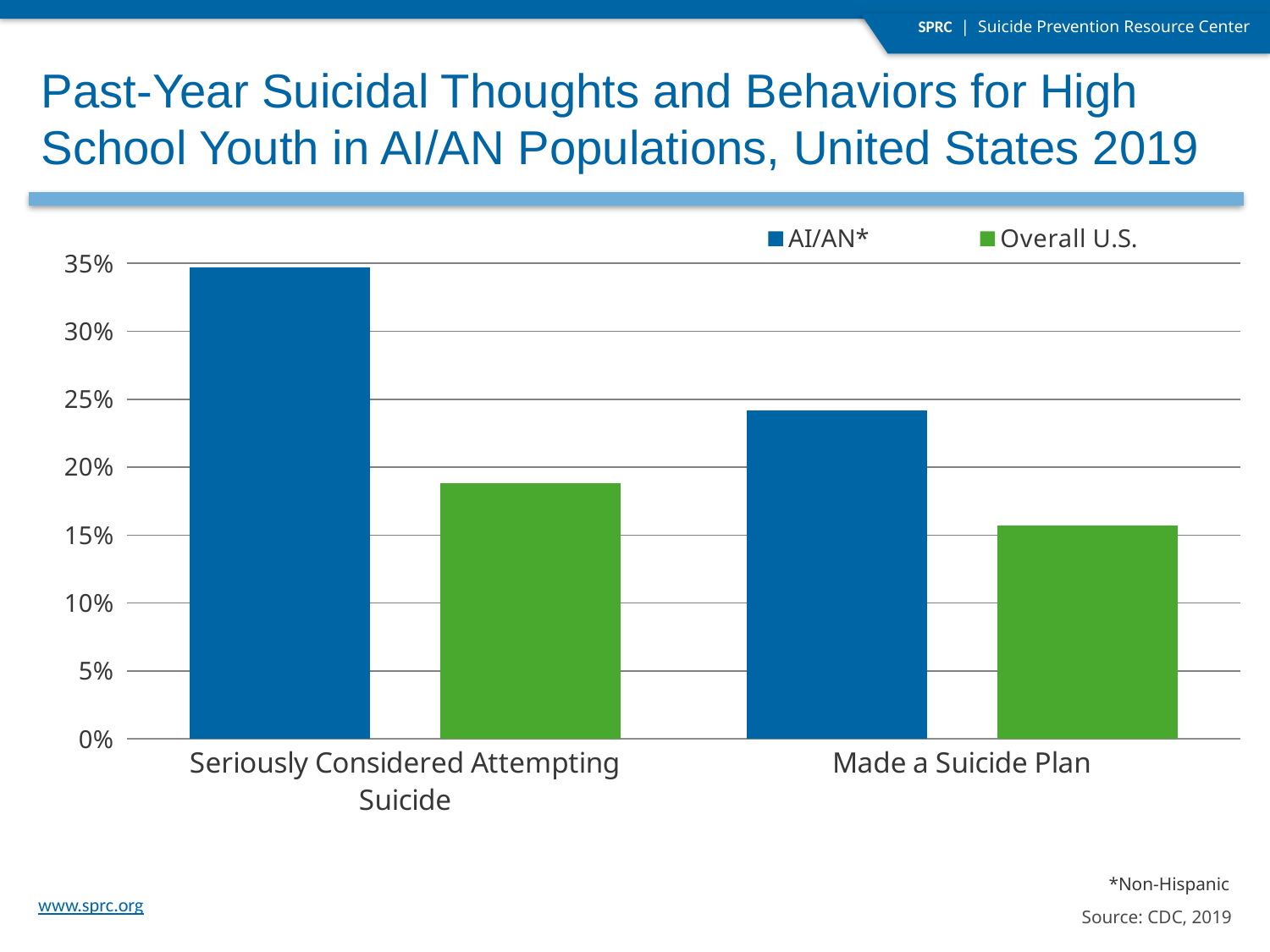
Which bar is the tallest in the chart? AI/AN* for Seriously Considered Attempting Suicide Is the AI/AN* value for Seriously Considered Attempting Suicide greater or less than 30%? greater How many series does the legend list? 2 Which is larger: the Overall U.S. value for Seriously Considered Attempting Suicide or the AI/AN* value for Made a Suicide Plan? AI/AN* value for Made a Suicide Plan What kind of chart is shown on the slide? Bar chart Is the Overall U.S. value for Made a Suicide Plan greater or less than 20%? less Is the Overall U.S. value for Seriously Considered Attempting Suicide greater or less than 20%? less Which bar is the shortest in the chart? Overall U.S. for Made a Suicide Plan How many categories are shown on the x axis? 2 For Made a Suicide Plan, which series has the larger value, AI/AN* or Overall U.S.? AI/AN* Which series is shown in blue? AI/AN*